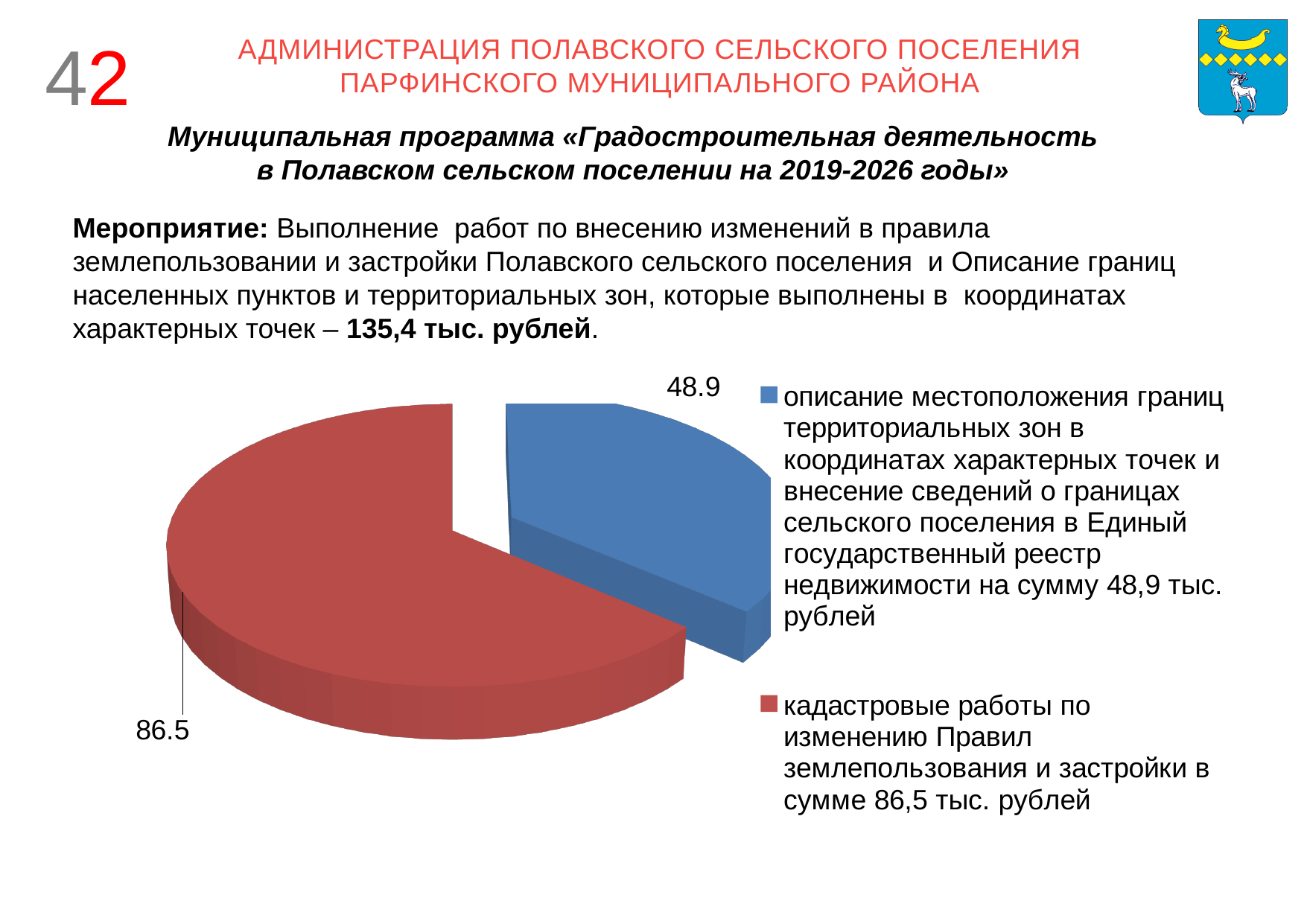
How many slices does the pie chart have? 2 How many entries does the legend of the pie chart list? 2 Which is larger: the slice for кадастровые работы or the slice for описание местоположения границ? кадастровые работы What is the difference between the two slice values in the pie chart? 37.6 What is the value of the slice for «описание местоположения границ территориальных зон в координатах характерных точек...»? 48.9 What is the total of the two slice values in the pie chart? 135.4 What type of chart is shown on the slide? pie chart What is the value of the slice for «кадастровые работы по изменению Правил землепользования и застройки»? 86.5 What colour is the slice for «кадастровые работы по изменению Правил землепользования и застройки»? red Which slice of the pie chart is the smallest? описание местоположения границ территориальных зон в координатах характерных точек What colour is the slice labelled 48.9? blue Which slice of the pie chart is the largest? кадастровые работы по изменению Правил землепользования и застройки